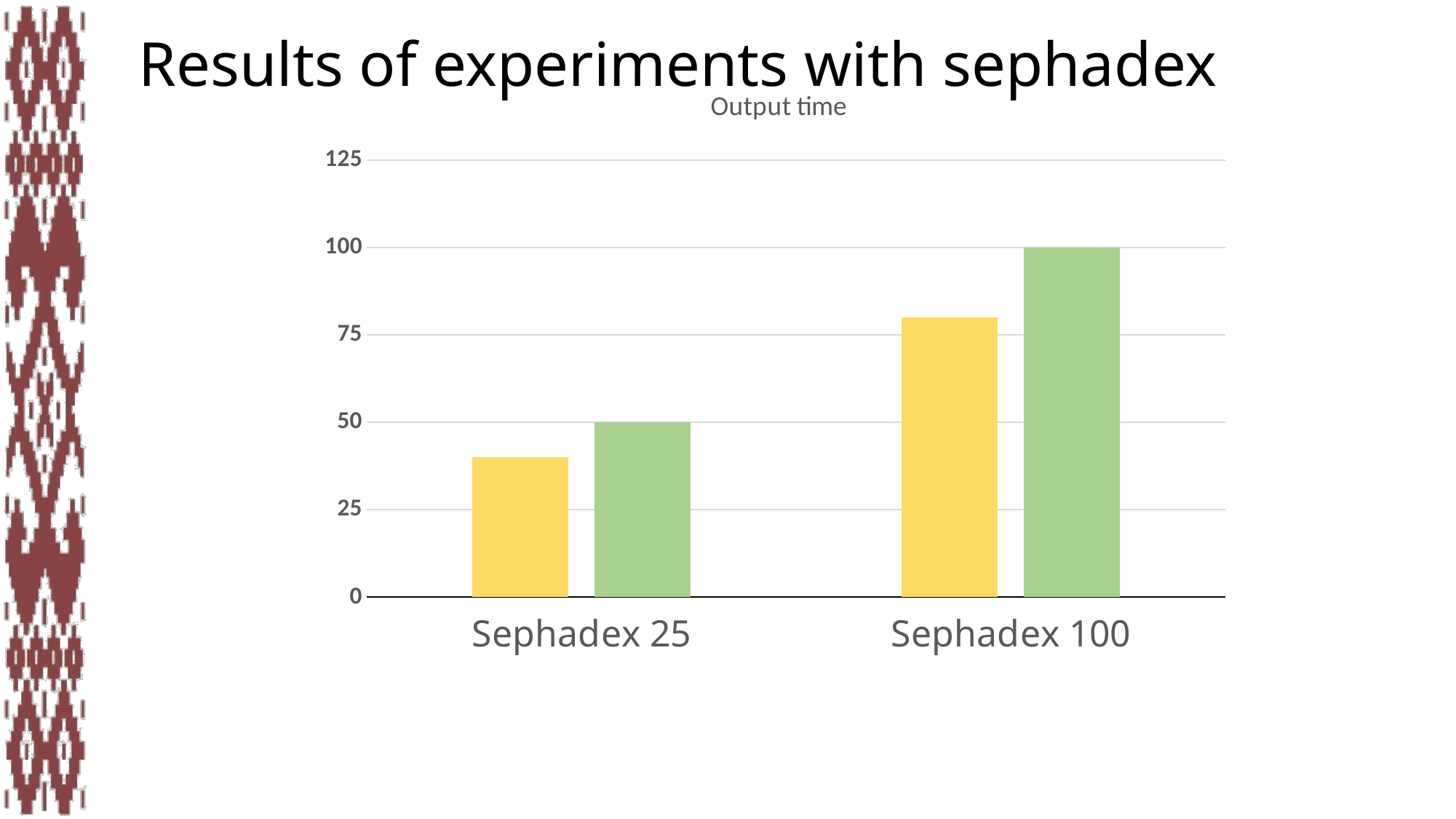
What kind of chart is shown on the slide? bar chart Is the value of the yellow bar for Sephadex 100 greater or less than 75? greater Which green bar is larger, Sephadex 25 or Sephadex 100? Sephadex 100 How many categories are shown on the x axis of the chart? 2 What is the value of the green bar for Sephadex 25? 50 Is the value of the yellow bar for Sephadex 25 greater or less than 50? less Which category has the tallest bar on the chart? Sephadex 100 What is the title of the chart? Output time What is the value of the green bar for Sephadex 100? 100 How many bars are plotted in total on the chart? 4 Do the values rise or fall from Sephadex 25 to Sephadex 100? rise What is the difference between the green bar for Sephadex 100 and the green bar for Sephadex 25? 50